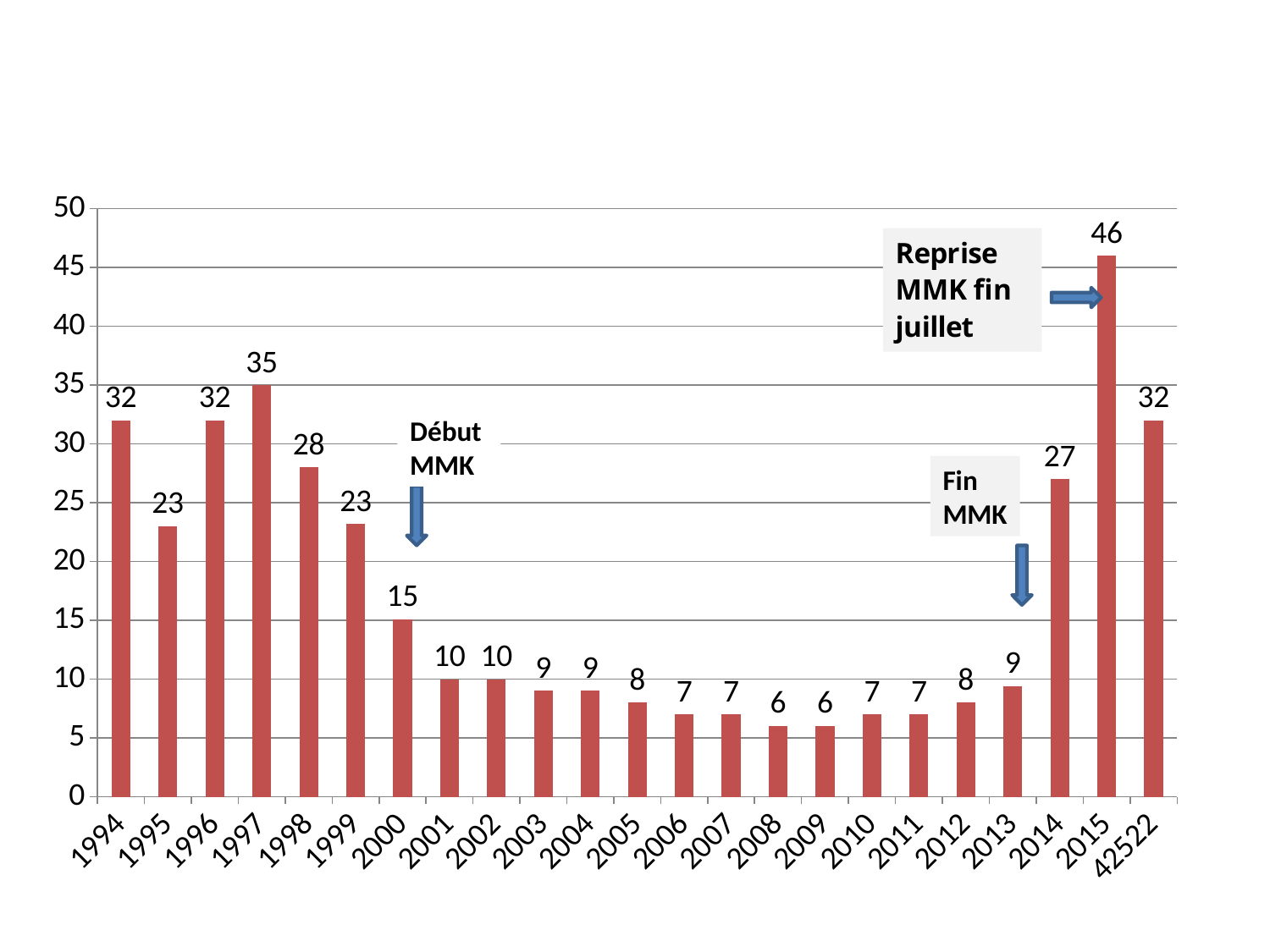
What is the value for 1997? 35 How many bars are plotted on the chart? 23 Which is larger, the value for 1995 or the value for 1998? 1998 What is the difference between the values for 1997 and 1998? 7 Do the values rise or fall from 1997 to 2000? Fall What is the highest value shown on the chart? 46 Which year has the highest value? 2015 What is the lowest value shown on the chart? 6 What is the value for 2000? 15 What is the difference between the values for 2015 and 2014? 19 What kind of chart is shown on the slide? Bar chart What is the value for 2014? 27